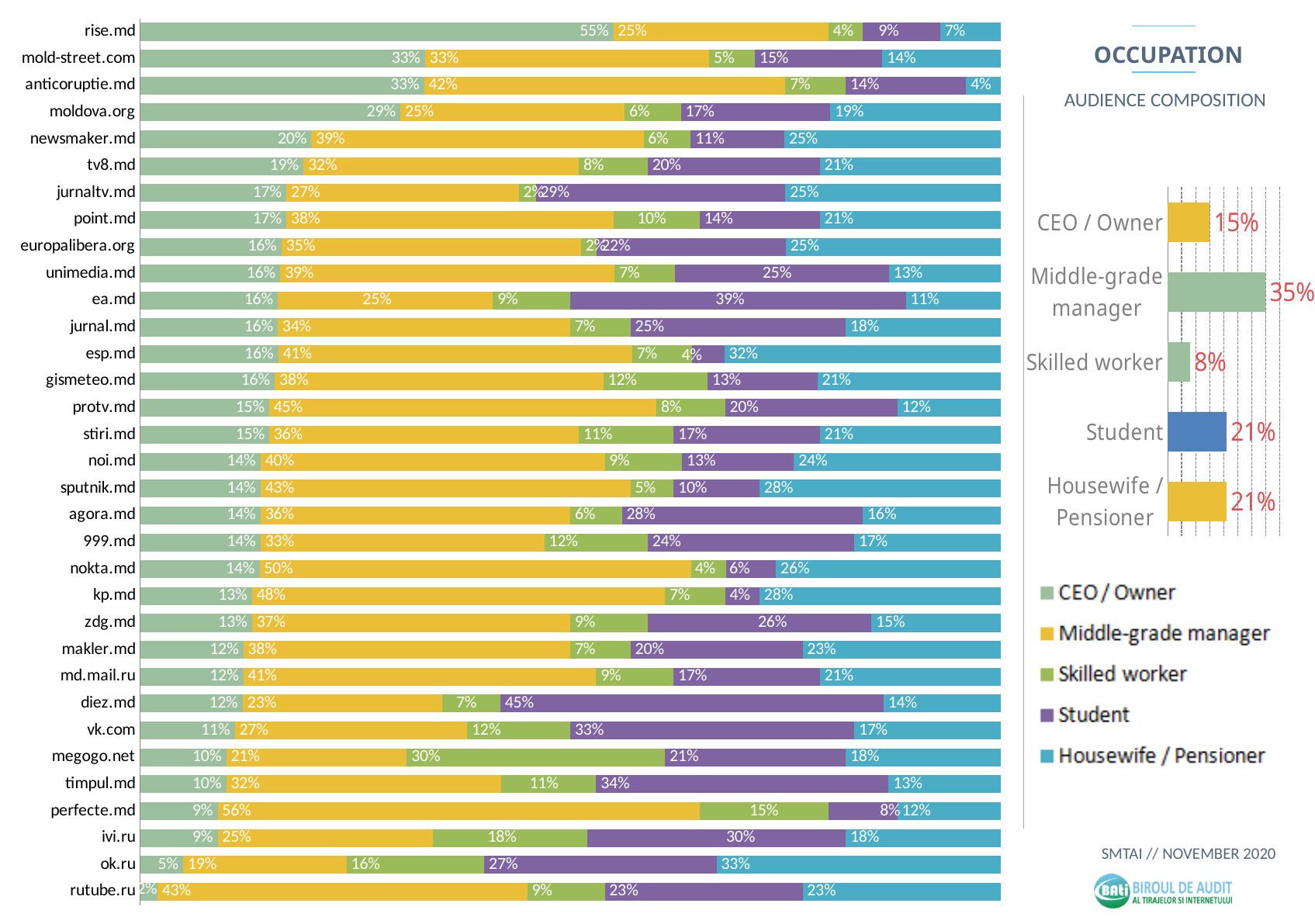
On the right chart titled OCCUPATION, which category has the lowest value? Skilled worker On the left stacked bar chart, what is the CEO / Owner share for rise.md? 55% How many series does the legend of the left stacked bar chart list? 5 On the left stacked bar chart, which has the larger Student share, diez.md or vk.com? diez.md How many websites are listed on the left stacked bar chart? 33 On the left stacked bar chart, which website has the lowest CEO / Owner share? rutube.ru On the left stacked bar chart, what is the Skilled worker share for megogo.net? 30% On the right chart titled OCCUPATION, what is the difference between Middle-grade manager and Skilled worker? 27 percentage points On the left stacked bar chart, what is the Student share for ea.md? 39% On the right chart titled OCCUPATION, what is the value for Middle-grade manager? 35% On the left stacked bar chart, what is the Middle-grade manager share for perfecte.md? 56% On the left stacked bar chart, which website has the highest CEO / Owner share? rise.md